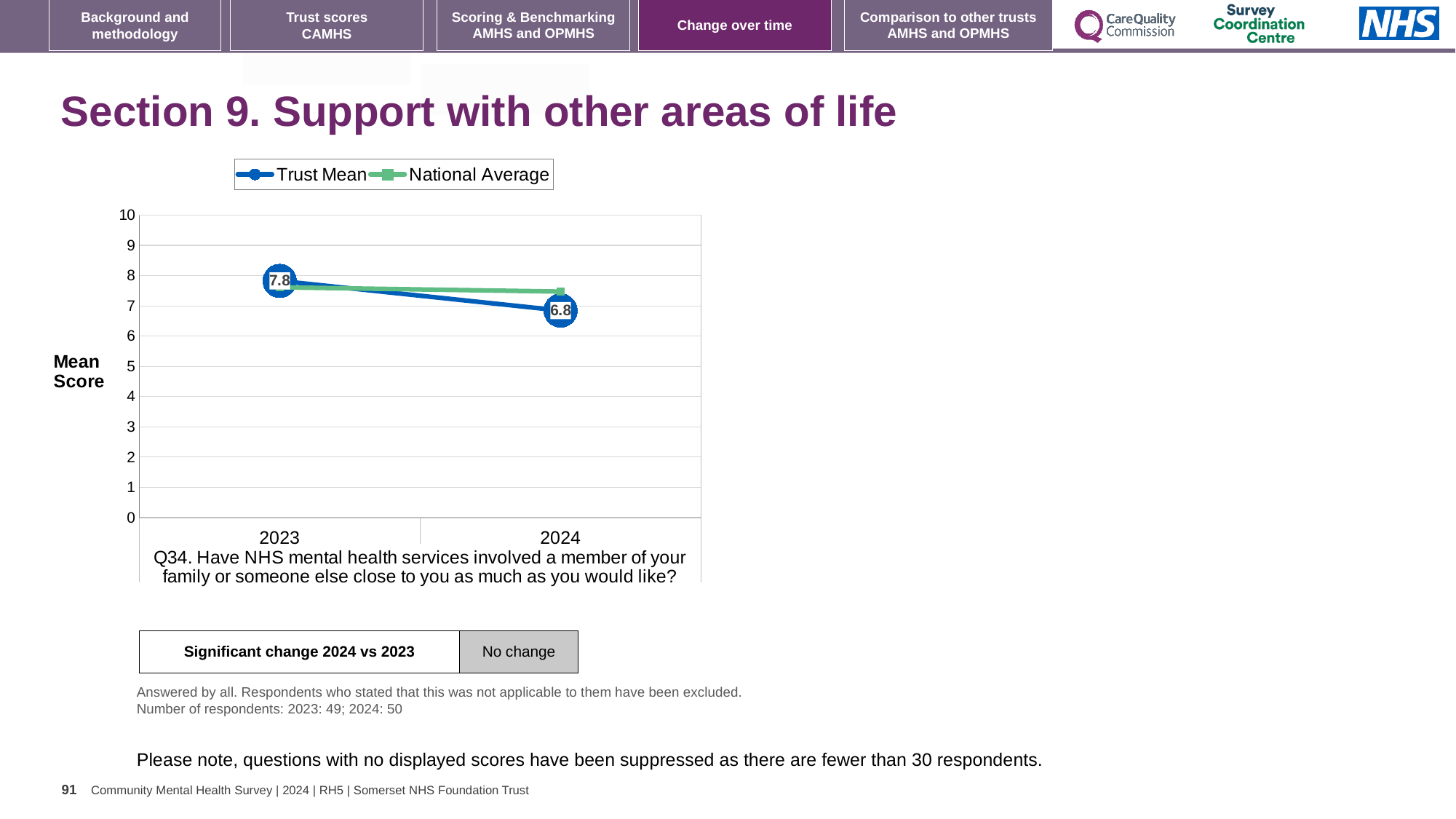
What is the Trust Mean score for 2024? 6.8 What is the Trust Mean score for 2023? 7.8 In 2024, which is higher: the Trust Mean or the National Average? National Average Does the Trust Mean line rise or fall from 2023 to 2024? fall By how much did the Trust Mean score change from 2023 to 2024? 1.0 What is the label on the y axis of the chart? Mean Score Which year has the higher Trust Mean score, 2023 or 2024? 2023 How many years are plotted on the x axis? 2 What kind of chart is shown on the slide? line chart Is the National Average value for 2023 greater or less than 7? greater How many series does the legend list? 2 Is the National Average value for 2024 greater or less than 5? greater